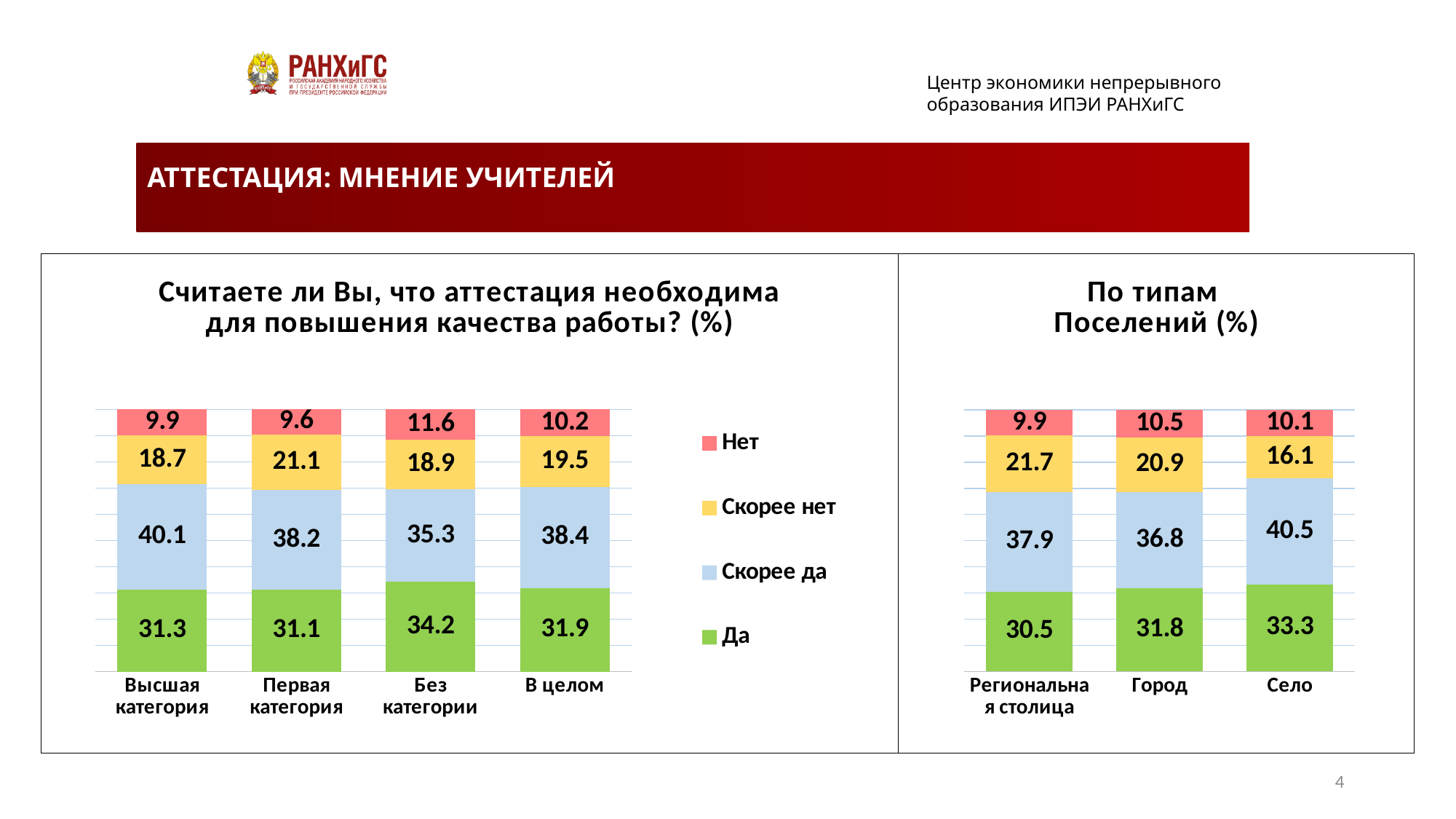
In the right chart (По типам Поселений), which is larger: «Да» for «Региональная столица» or «Да» for «Село»? Село In the right chart (По типам Поселений), which settlement type has the lowest value for «Скорее нет»? Село What type of chart is the right chart (По типам Поселений)? Stacked bar chart How many series does the legend list? 4 In the left chart, which category has the highest value for «Нет»? Без категории In the right chart (По типам Поселений), what is the value of «Скорее да» for «Село»? 40.5 In the right chart (По типам Поселений), what is the total of the stacked bar for «Село»? 100.0 In the left chart, what is the difference between the «Скорее да» values for «Высшая категория» and «Без категории»? 4.8 In the left chart (Считаете ли Вы, что аттестация необходима для повышения качества работы?), what is the value of «Да» for «Без категории»? 34.2 How many categories are shown on the x axis of the left chart? 4 In the left chart, what is the value of «Скорее нет» for «Первая категория»? 21.1 In the right chart (По типам Поселений), what is the value of «Нет» for «Город»? 10.5